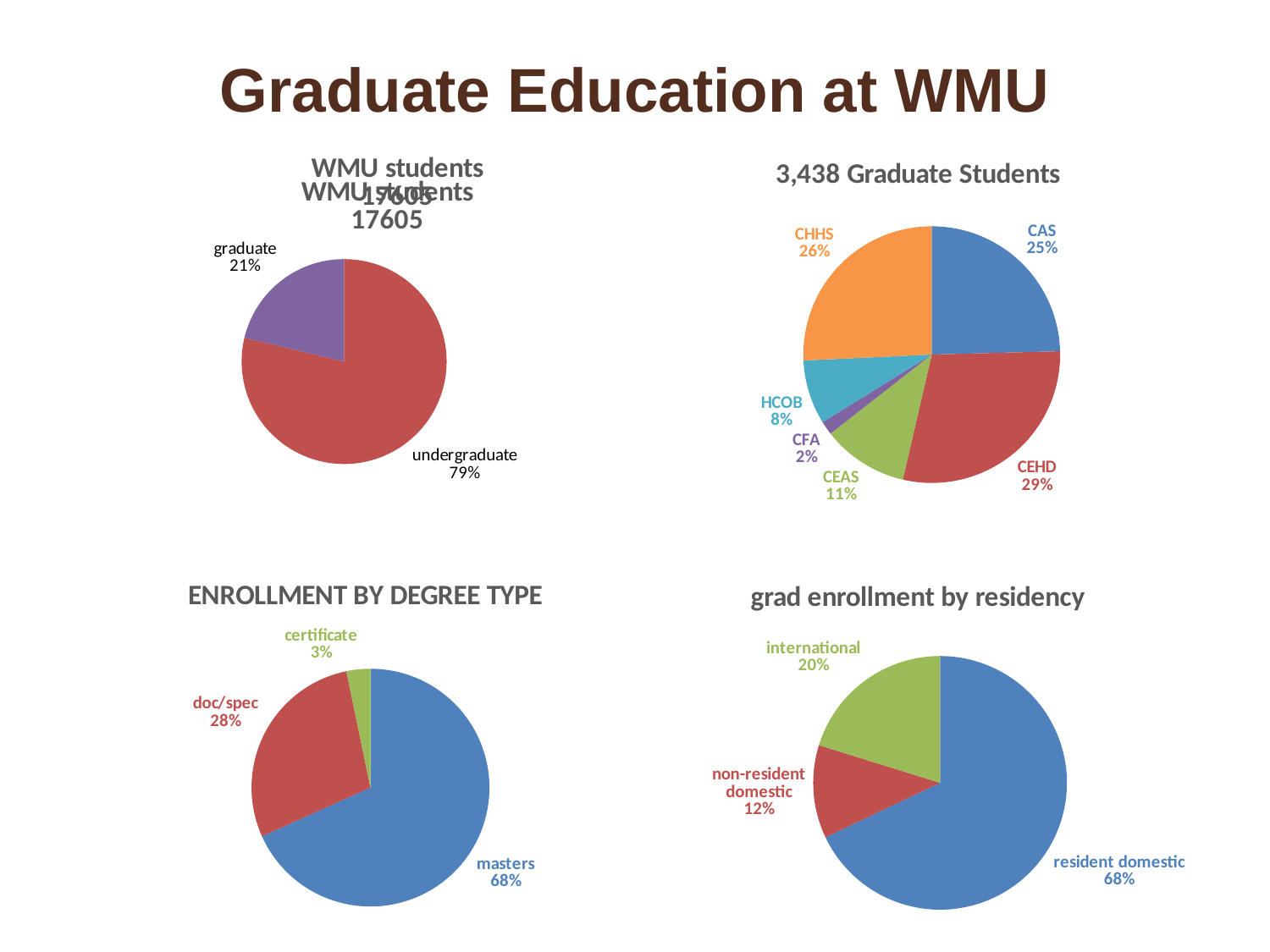
In the '3,438 Graduate Students' pie chart, what is the difference in percentage points between CHHS and HCOB? 18 In the 'WMU students 17605' pie chart (top left), which is larger, graduate or undergraduate? undergraduate In the 'ENROLLMENT BY DEGREE TYPE' chart, which degree type has the smallest share? certificate In the 'grad enrollment by residency' chart, what share is international? 20% What kind of chart is the 'grad enrollment by residency' chart? pie chart In the '3,438 Graduate Students' pie chart, which college has the smallest share? CFA In the 'WMU students 17605' pie chart (top left), what share is undergraduate? 79% In the '3,438 Graduate Students' pie chart, which college has the largest share? CEHD In the 'ENROLLMENT BY DEGREE TYPE' chart, what share is doc/spec? 28% In the 'grad enrollment by residency' chart, what is the difference in percentage points between resident domestic and non-resident domestic? 56 In the '3,438 Graduate Students' pie chart, what share does CEHD have? 29% In the '3,438 Graduate Students' pie chart, how many colleges are shown? 6